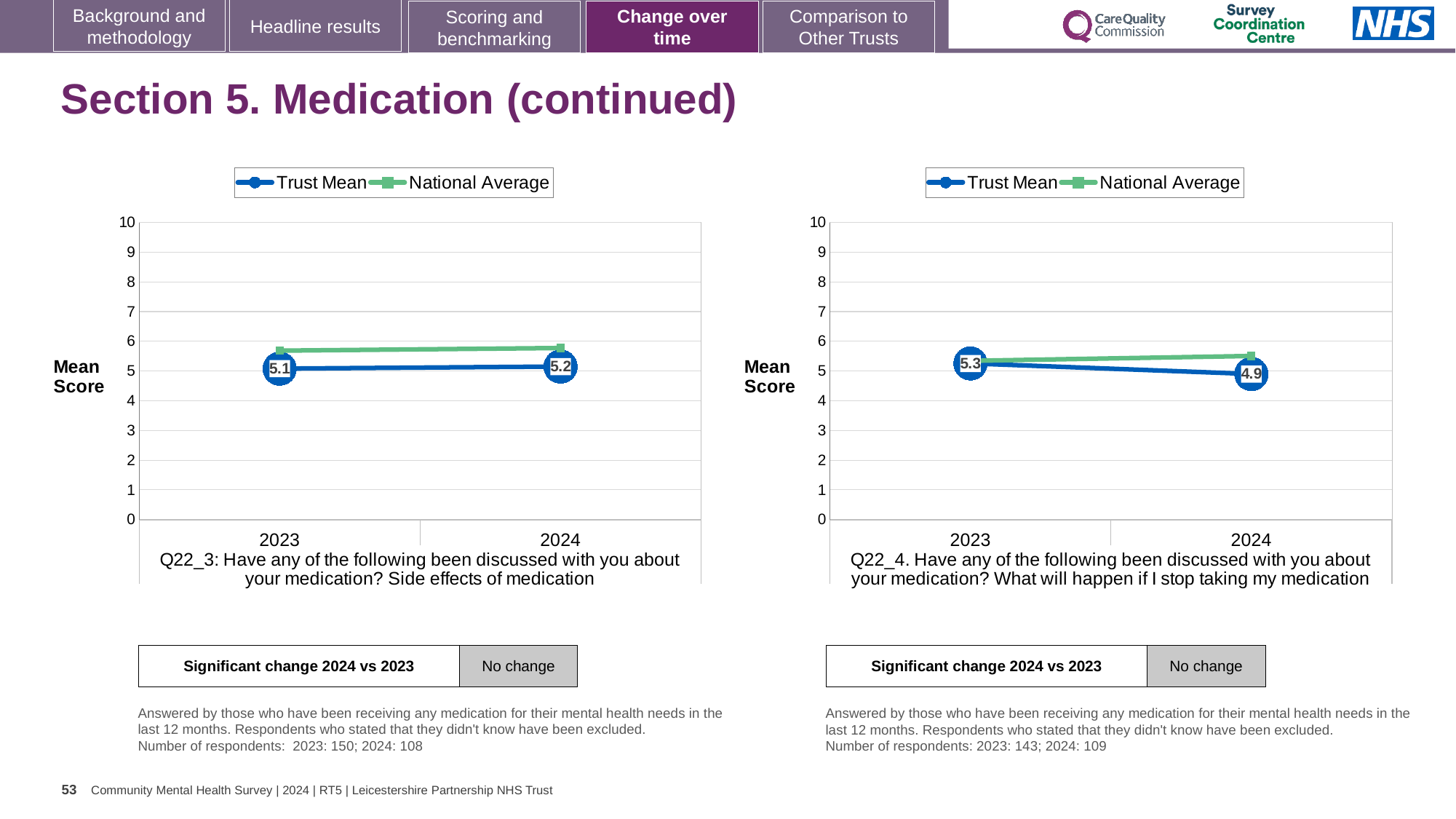
In the left chart (Q22_3), is the National Average for 2024 greater or less than 5? greater What kind of chart is the right chart (Q22_4)? line chart In the left chart (Q22_3), what is the Trust Mean score for 2023? 5.1 In the right chart (Q22_4), does the Trust Mean rise or fall from 2023 to 2024? fall In the right chart (Q22_4), by how much did the Trust Mean change from 2023 to 2024? 0.4 In the right chart (Q22_4), which is higher in 2024, the Trust Mean or the National Average? National Average In the right chart (Q22_4), what is the Trust Mean score for 2024? 4.9 In the left chart (Q22_3), what is the difference between the Trust Mean for 2024 and 2023? 0.1 How many series does the legend of the left chart (Q22_3) list? 2 In the right chart (Q22_4), what is the Trust Mean score for 2023? 5.3 In the left chart (Q22_3), does the Trust Mean rise or fall from 2023 to 2024? rise In the left chart (Q22_3), what is the Trust Mean score for 2024? 5.2